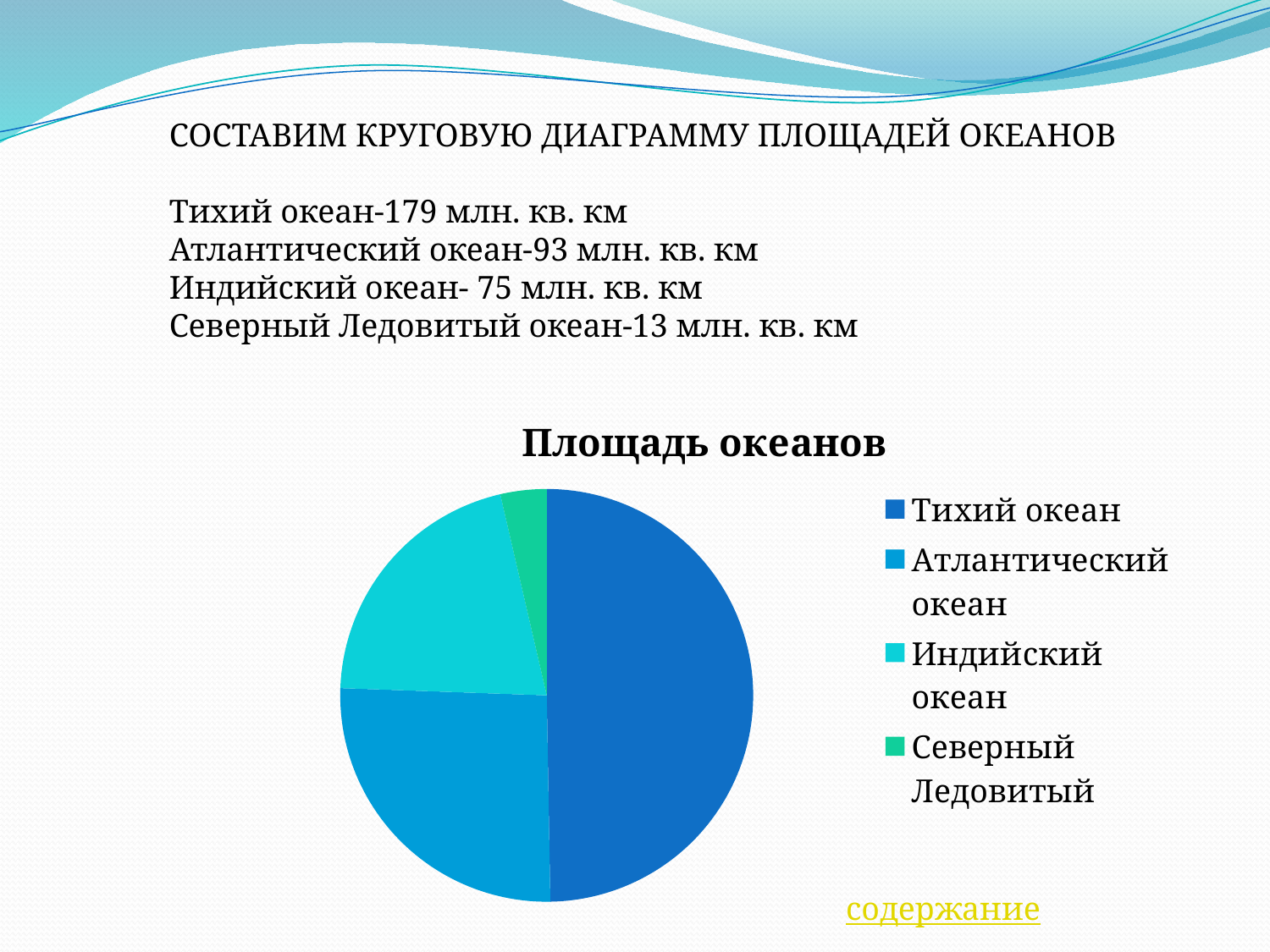
What is the title of the chart? Площадь океанов According to the slide, what is the area of Индийский океан? 75 млн. кв. км According to the slide, what is the area of Тихий океан? 179 млн. кв. км Which ocean has the largest slice in the pie chart? Тихий океан How many slices does the pie chart have? 4 How many entries does the legend of the pie chart list? 4 According to the slide, what is the area of Атлантический океан? 93 млн. кв. км Which ocean has the smallest slice in the pie chart? Северный Ледовитый What kind of chart is shown on the slide? pie chart According to the slide, what is the area of Северный Ледовитый океан? 13 млн. кв. км By how much does the area of Тихий океан exceed the area of Атлантический океан, according to the slide? 86 млн. кв. км Which slice is larger in the pie chart: Атлантический океан or Индийский океан? Атлантический океан